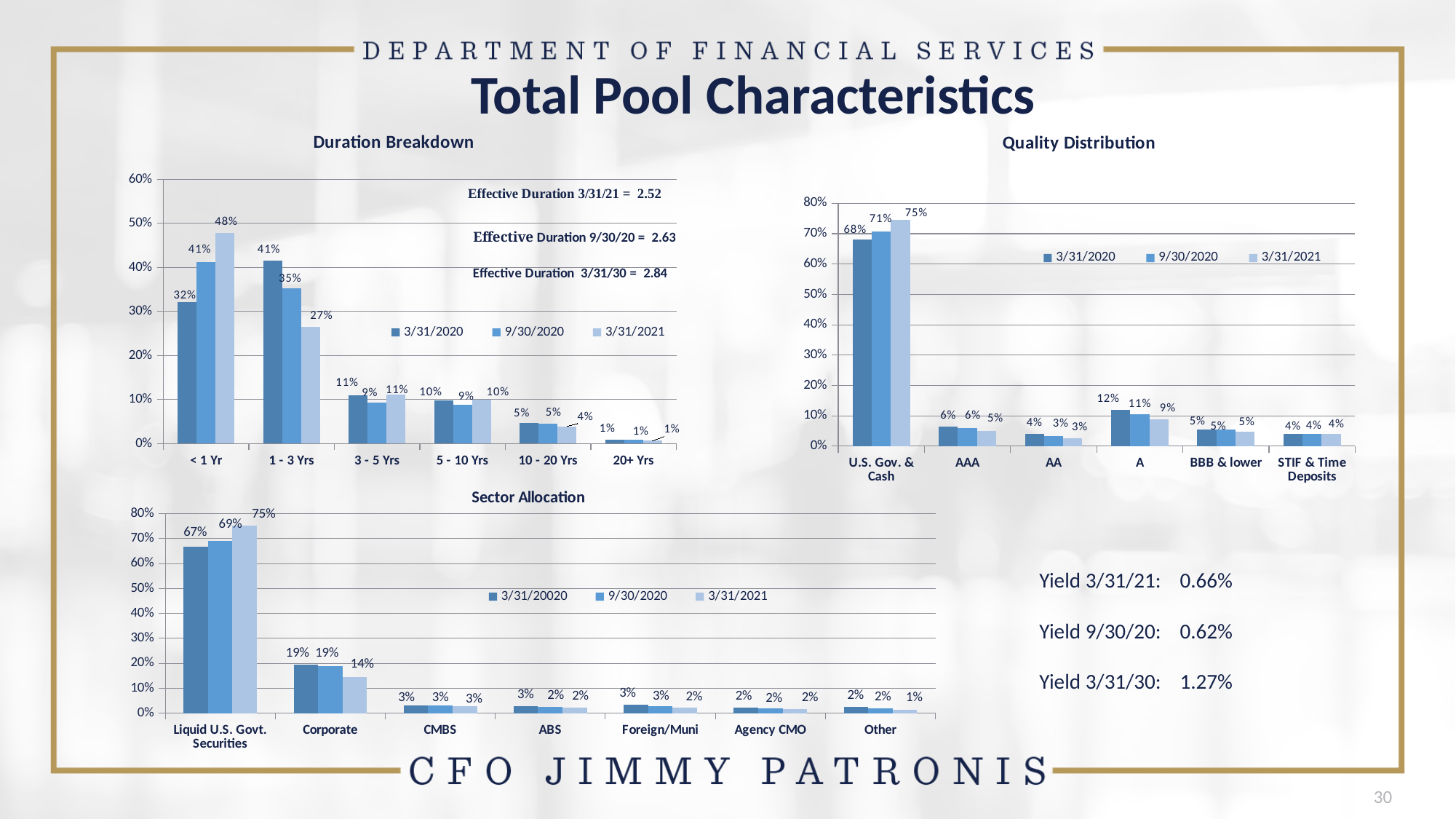
In the Quality Distribution chart, how many series does the legend list? 3 In the Quality Distribution chart, what is the value for A in the 3/31/2020 series? 12% In the Quality Distribution chart, which category has the highest value in the 3/31/2021 series? U.S. Gov. & Cash In the Quality Distribution chart, what is the value for U.S. Gov. & Cash in the 9/30/2020 series? 71% What kind of chart is the Sector Allocation chart? Bar chart In the Sector Allocation chart, how many sector categories are shown on the x axis? 7 In the Duration Breakdown chart, how many duration categories are shown on the x axis? 6 In the Duration Breakdown chart, what is the value for < 1 Yr in the 3/31/2021 series? 48% In the Duration Breakdown chart, what is the value for 1 - 3 Yrs in the 3/31/2020 series? 41% In the Duration Breakdown chart, what is the difference between the 3/31/2021 and 3/31/2020 values for < 1 Yr? 16% In the Sector Allocation chart, what is the value for Corporate in the 3/31/2021 series? 14% In the Sector Allocation chart, which is larger for Liquid U.S. Govt. Securities: the 3/31/2021 value or the 9/30/2020 value? 3/31/2021